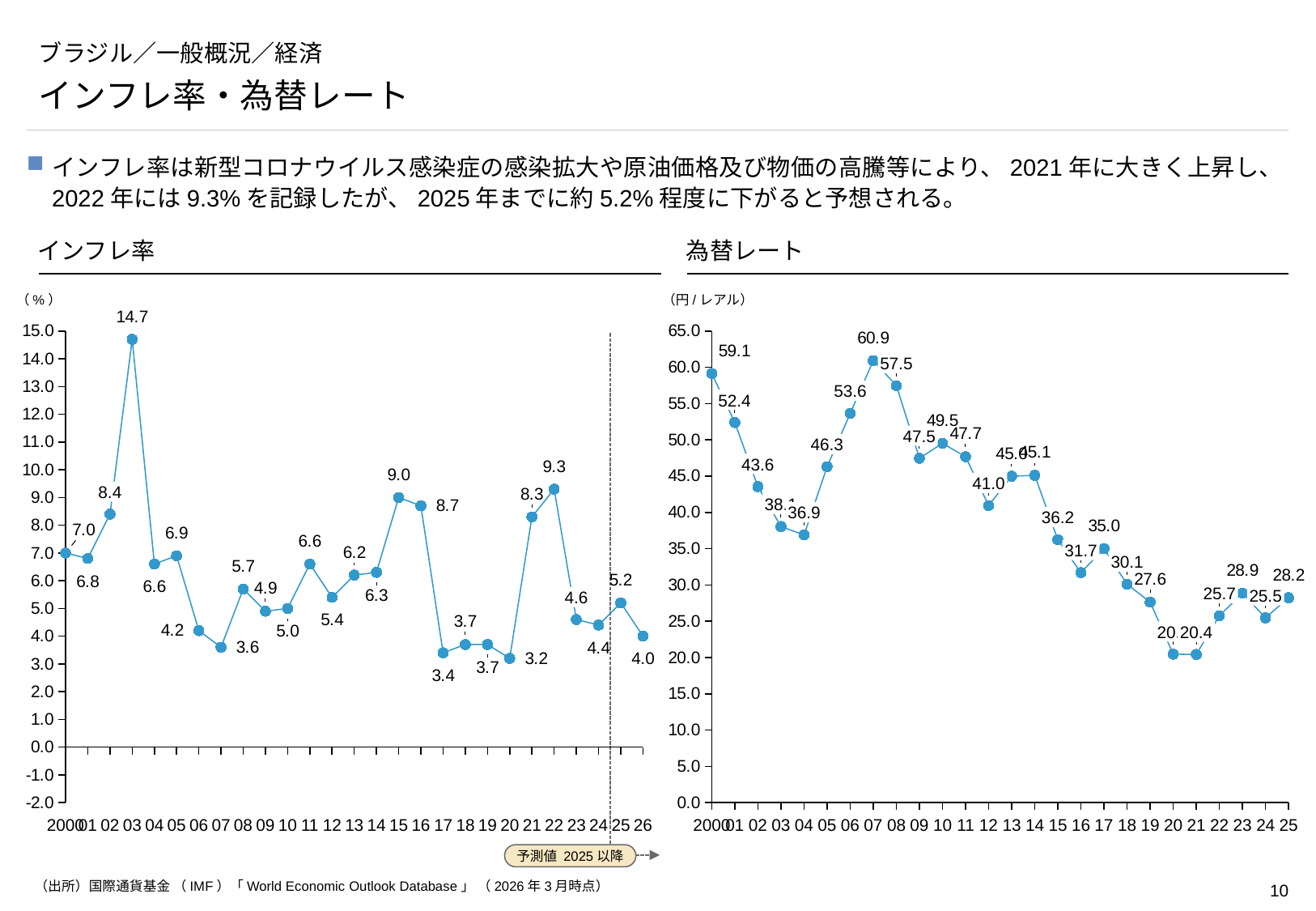
What kind of chart is the 為替レート chart? line chart On the 為替レート chart, what is the value for 2025? 28.2 On the 為替レート chart, what is the difference between the 2000 value and the 2001 value? 6.7 On the インフレ率 chart, which year has the lowest inflation rate? 2020 On the 為替レート chart, what is the value for 2007? 60.9 On the インフレ率 chart, what is the inflation rate for 2003? 14.7 On the 為替レート chart, which year has the highest value? 2007 On the インフレ率 chart, how many data points are plotted? 27 On the インフレ率 chart, what is the value for 2022? 9.3 On the インフレ率 chart, which is larger, the value for 2015 or the value for 2016? 2015 On the インフレ率 chart, what is the difference between the 2022 value and the 2023 value? 4.7 On the インフレ率 chart, which year has the highest inflation rate? 2003